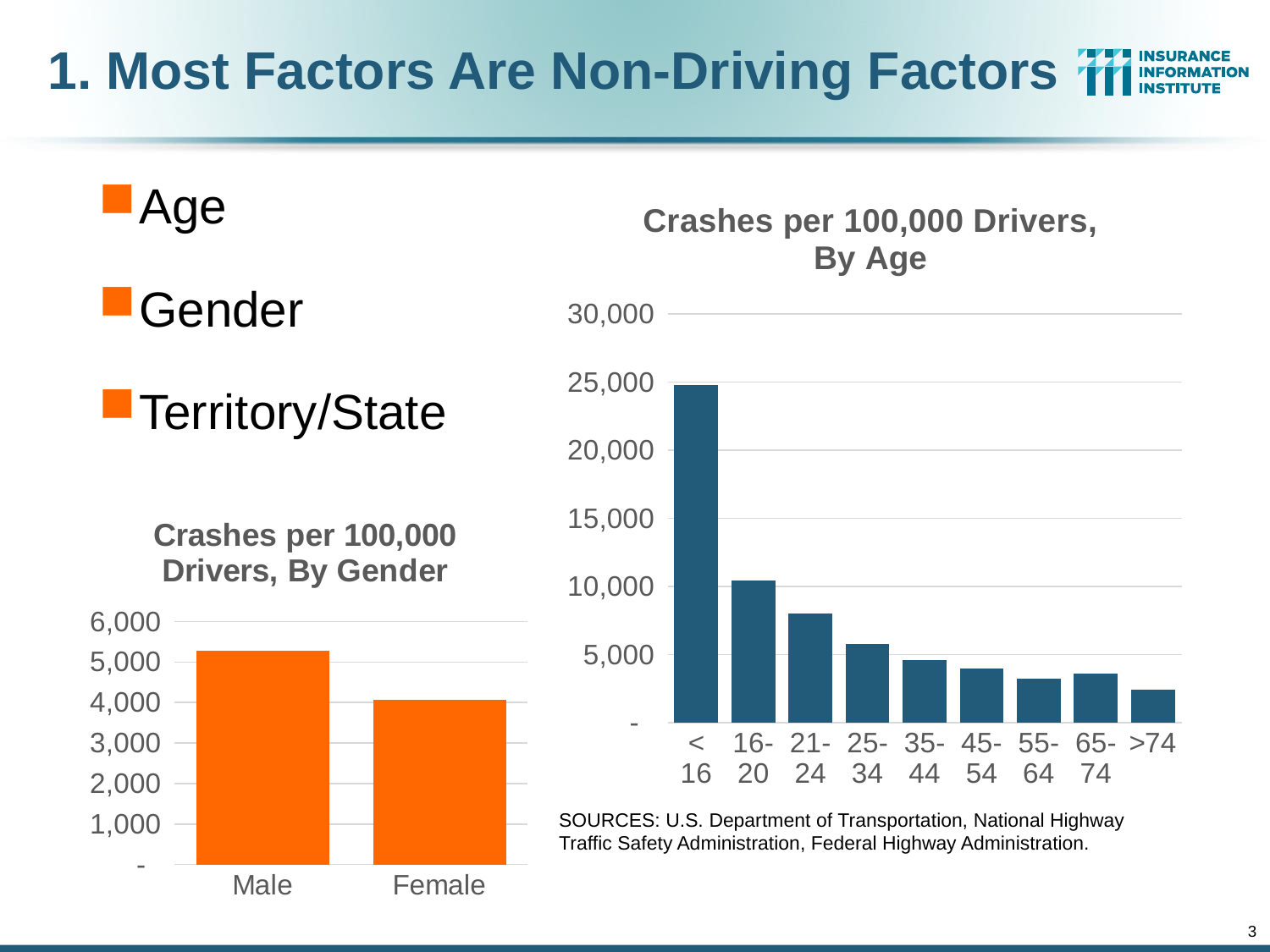
In the 'Crashes per 100,000 Drivers, By Age' chart, is the value for the 21-24 age group greater or less than 10,000? less In the 'Crashes per 100,000 Drivers, By Age' chart, is the value for the 16-20 age group greater or less than 10,000? greater What kind of chart is 'Crashes per 100,000 Drivers, By Gender'? Bar chart In the 'Crashes per 100,000 Drivers, By Age' chart, which is larger, the value for 25-34 or the value for 45-54? 25-34 How many categories are shown in the 'Crashes per 100,000 Drivers, By Gender' chart? 2 In the 'Crashes per 100,000 Drivers, By Gender' chart, is the value for Female greater or less than 5,000? less In the 'Crashes per 100,000 Drivers, By Gender' chart, which gender has the higher value? Male In the 'Crashes per 100,000 Drivers, By Age' chart, which age group has the lowest value? >74 In the 'Crashes per 100,000 Drivers, By Age' chart, which age group has the highest value? < 16 How many age groups are shown in the 'Crashes per 100,000 Drivers, By Age' chart? 9 In the 'Crashes per 100,000 Drivers, By Age' chart, do the values generally rise or fall as age increases from < 16 to 55-64? fall